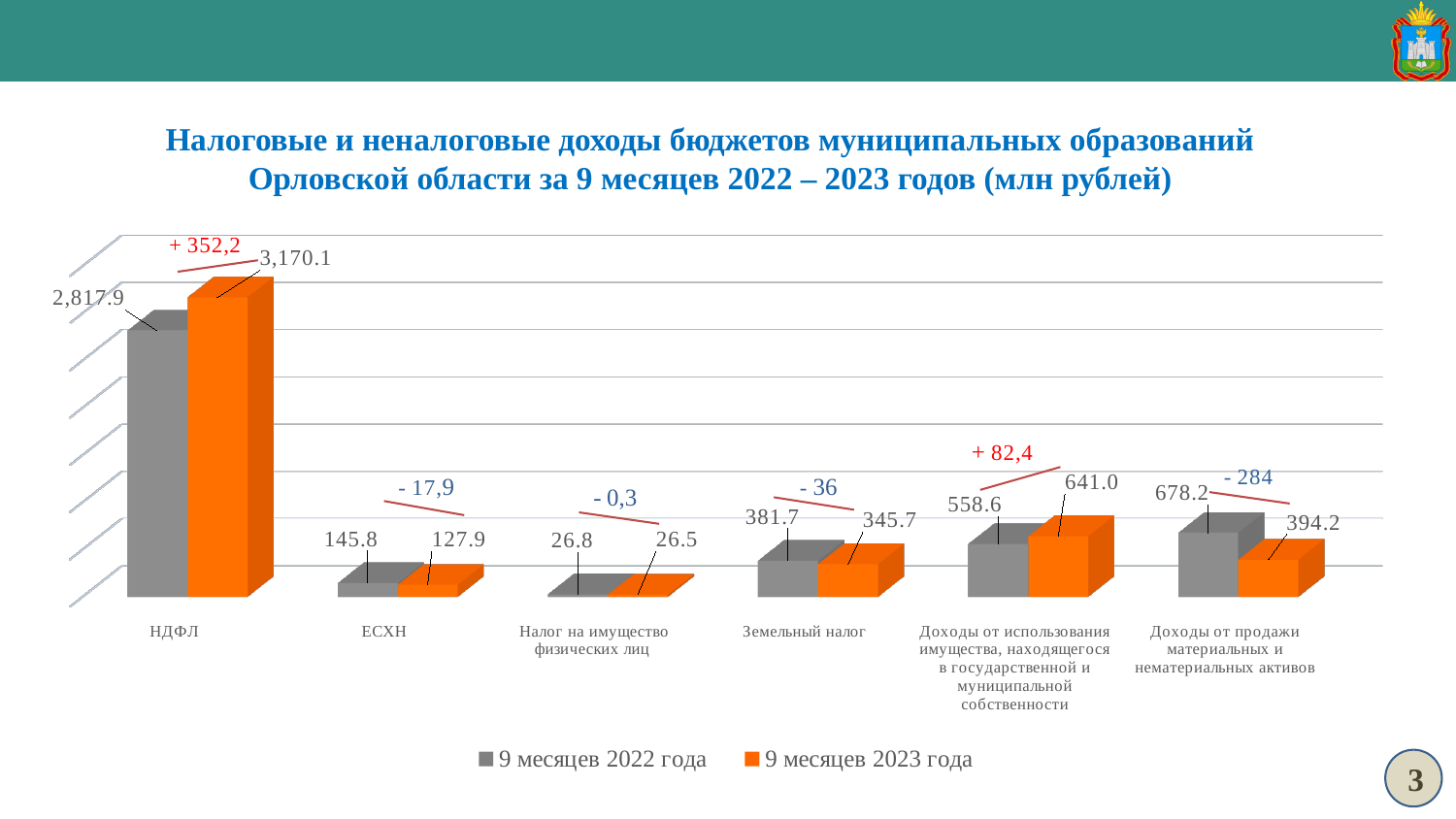
What is the value for НДФЛ in the series 9 месяцев 2023 года? 3,170.1 What is the difference between the 9 месяцев 2023 года and 9 месяцев 2022 года values for Доходы от использования имущества, находящегося в государственной и муниципальной собственности? 82.4 Which is larger for Земельный налог: the value for 9 месяцев 2022 года or for 9 месяцев 2023 года? 9 месяцев 2022 года What is the value for Земельный налог in the series 9 месяцев 2022 года? 381.7 What is the value for Доходы от продажи материальных и нематериальных активов in the series 9 месяцев 2022 года? 678.2 How many categories are shown on the x axis of the chart? 6 What kind of chart is shown on the slide? Bar chart Which category has the lowest value in the series 9 месяцев 2022 года? Налог на имущество физических лиц Which is larger for Доходы от использования имущества, находящегося в государственной и муниципальной собственности: the value for 9 месяцев 2022 года or for 9 месяцев 2023 года? 9 месяцев 2023 года How many series does the legend list? 2 Which category has the highest value in the series 9 месяцев 2023 года? НДФЛ What is the value for ЕСХН in the series 9 месяцев 2023 года? 127.9